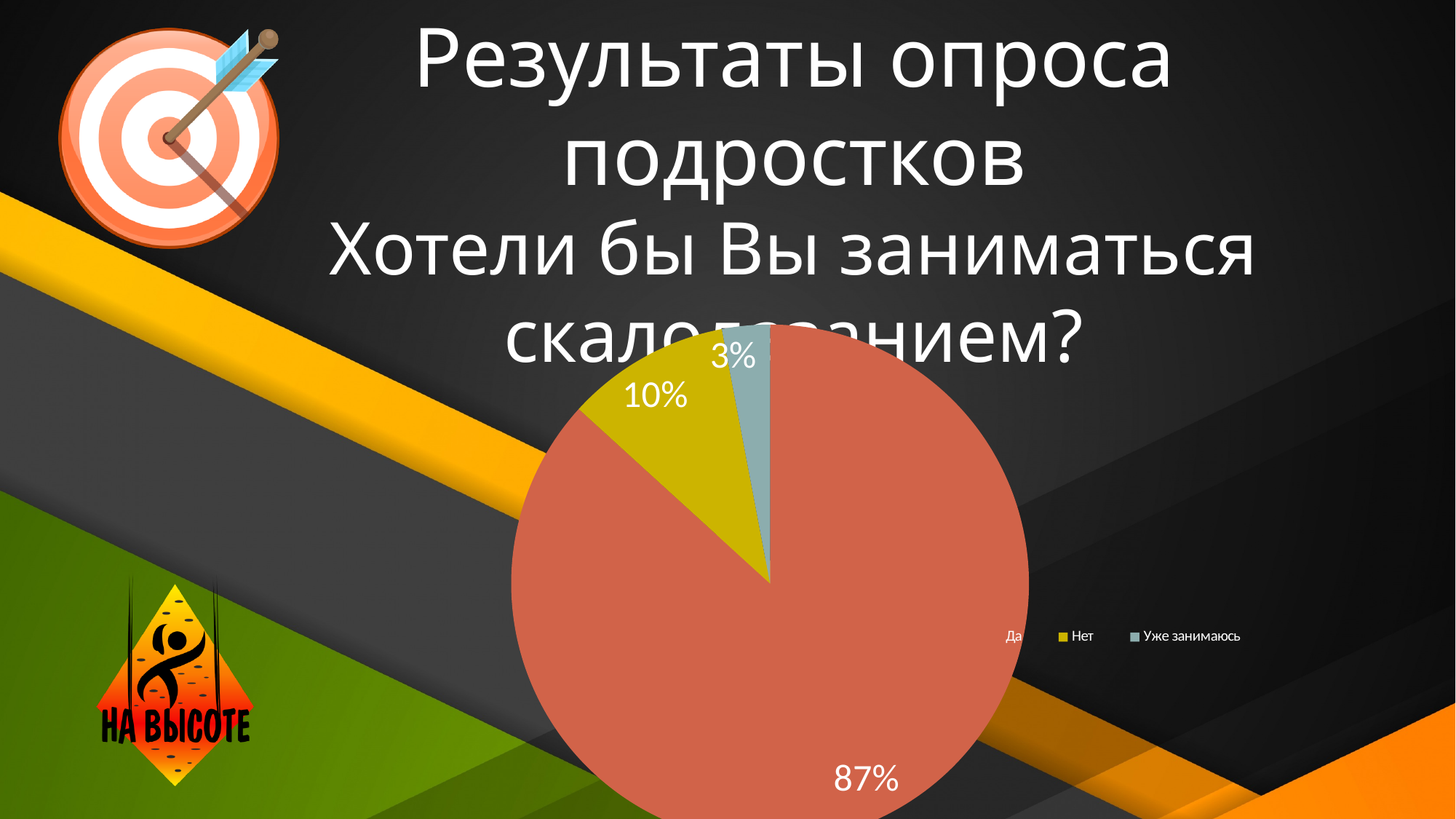
How many entries does the legend list? 3 What is the difference in percentage points between the "Да" and "Нет" slices? 77 What colour is the "Нет" slice in the pie chart? yellow What kind of chart is shown on the slide? pie chart What share of the pie does the "Уже занимаюсь" slice represent? 3% What share of the pie does the "Нет" slice represent? 10% What share of the pie does the "Да" slice represent? 87% Which category has the smallest slice of the pie? Уже занимаюсь Which category has the largest slice of the pie? Да Which slice is larger, "Нет" or "Уже занимаюсь"? Нет How many slices does the pie chart have? 3 What is the difference in percentage points between the "Нет" and "Уже занимаюсь" slices? 7